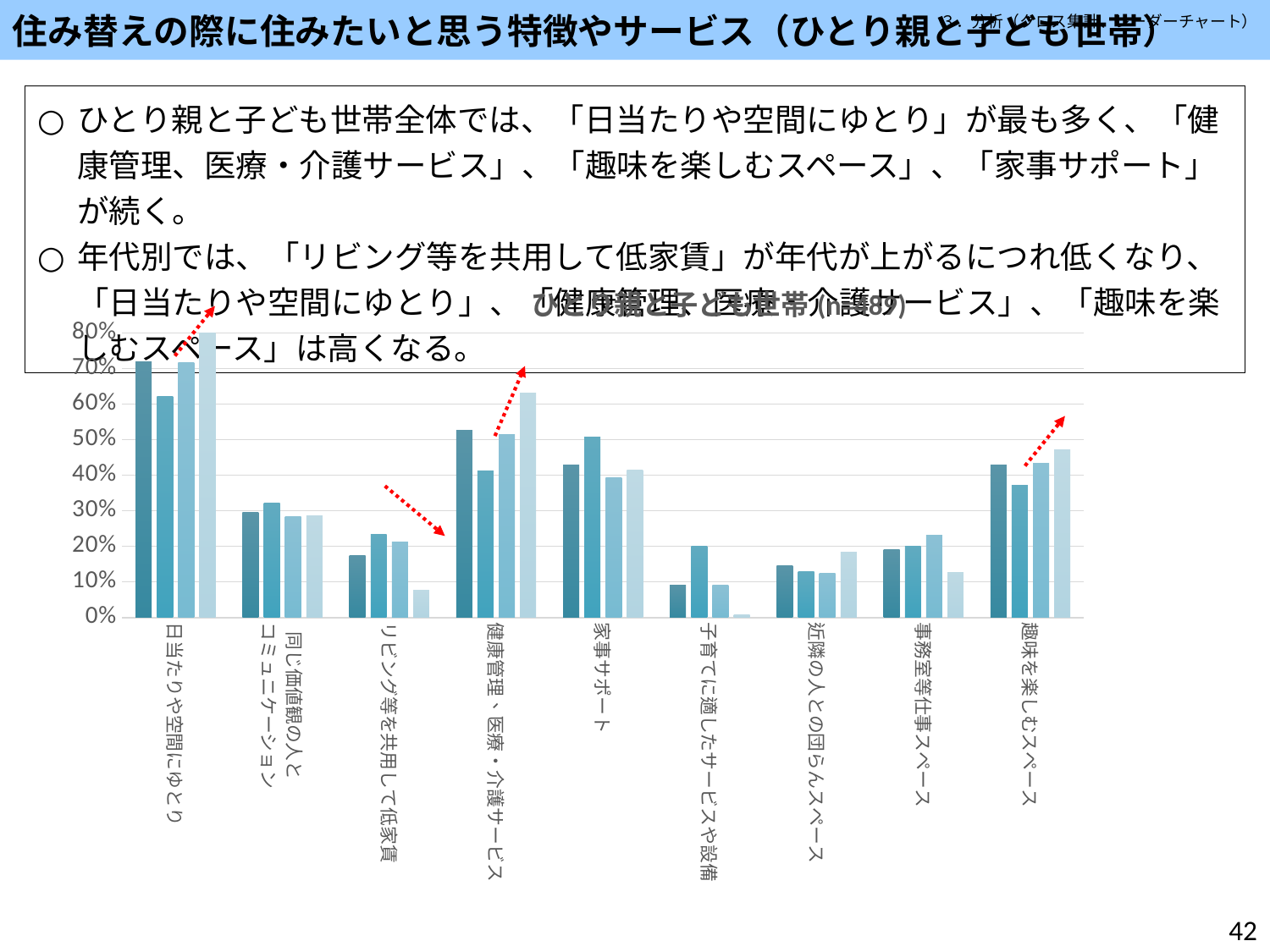
Which category has larger bars overall, 日当たりや空間にゆとり or 同じ価値観の人とコミュニケーション? 日当たりや空間にゆとり Which category has the tallest bars in the chart? 日当たりや空間にゆとり Is the value of the leftmost bar for 家事サポート greater or less than 30%? greater Is the value of the rightmost bar for リビング等を共用して低家賃 greater or less than 10%? less What is the highest value shown on the chart's vertical axis? 80% Is the value of the leftmost bar for 日当たりや空間にゆとり greater or less than 60%? greater What kind of chart is shown on the slide? bar chart How many categories are shown along the x axis of the chart? 9 Which category has larger bars overall, 家事サポート or 近隣の人との団らんスペース? 家事サポート Which category contains the shortest bar in the chart? 子育てに適したサービスや設備